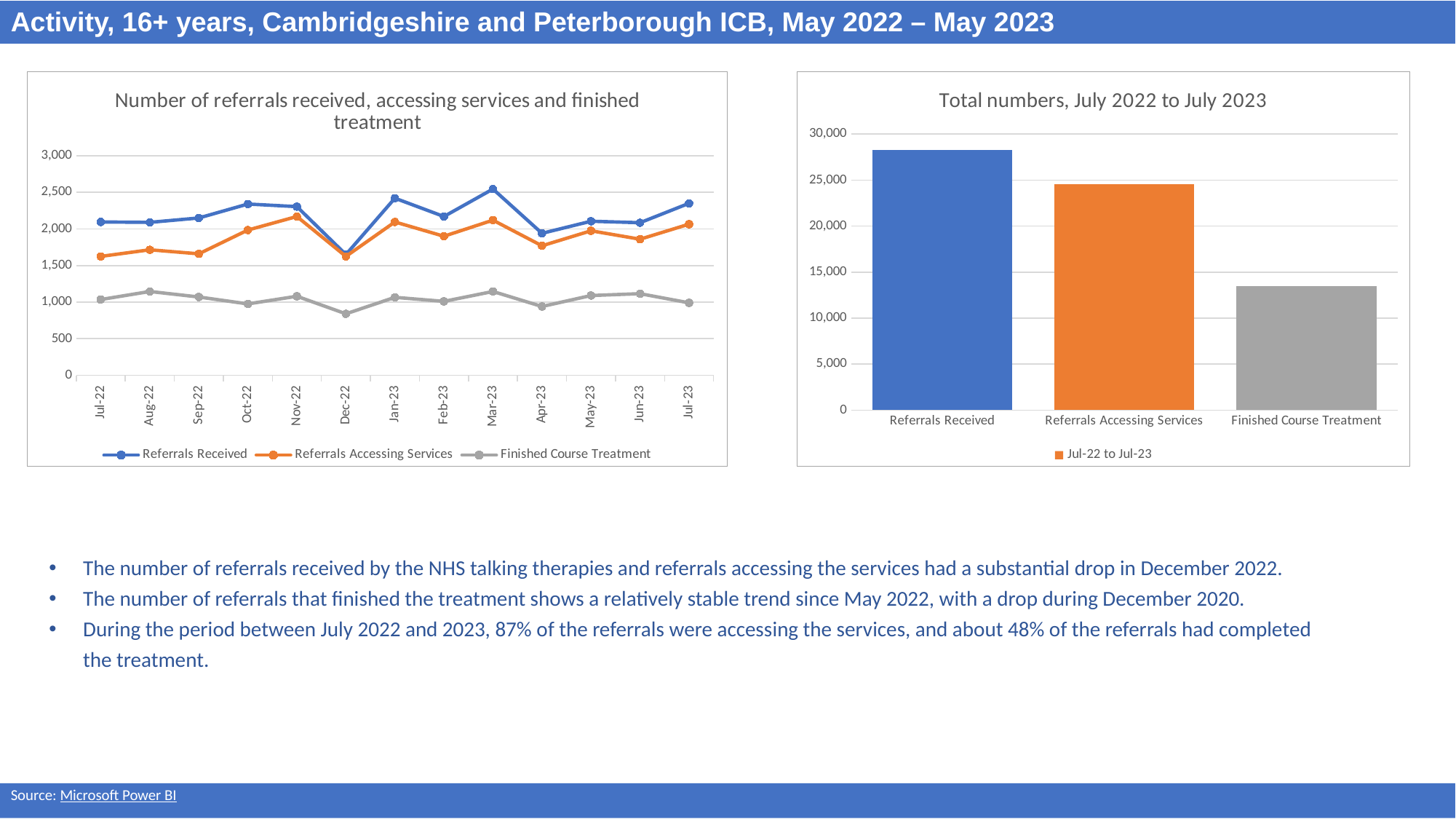
On the right chart, is the value for Finished Course Treatment greater or less than 15,000? less On the left chart, in which month is the Referrals Received value highest? Mar-23 On the left chart, in which month is the Finished Course Treatment value lowest? Dec-22 On the right chart, which category has the highest total? Referrals Received On the left chart, is the Referrals Received value for Dec-22 greater or less than 2,000? less On the left chart, 'Number of referrals received, accessing services and finished treatment', what kind of chart is it? Line chart On the right chart, 'Total numbers, July 2022 to July 2023', what kind of chart is it? Bar chart On the left chart, in which month is the Referrals Received value lowest? Dec-22 On the left chart, how many series does the legend list? 3 On the right chart, which is larger, Referrals Accessing Services or Finished Course Treatment? Referrals Accessing Services On the left chart, is the Referrals Received value for Mar-23 greater or less than 2,500? greater On the left chart, how many months are shown on the x axis? 13